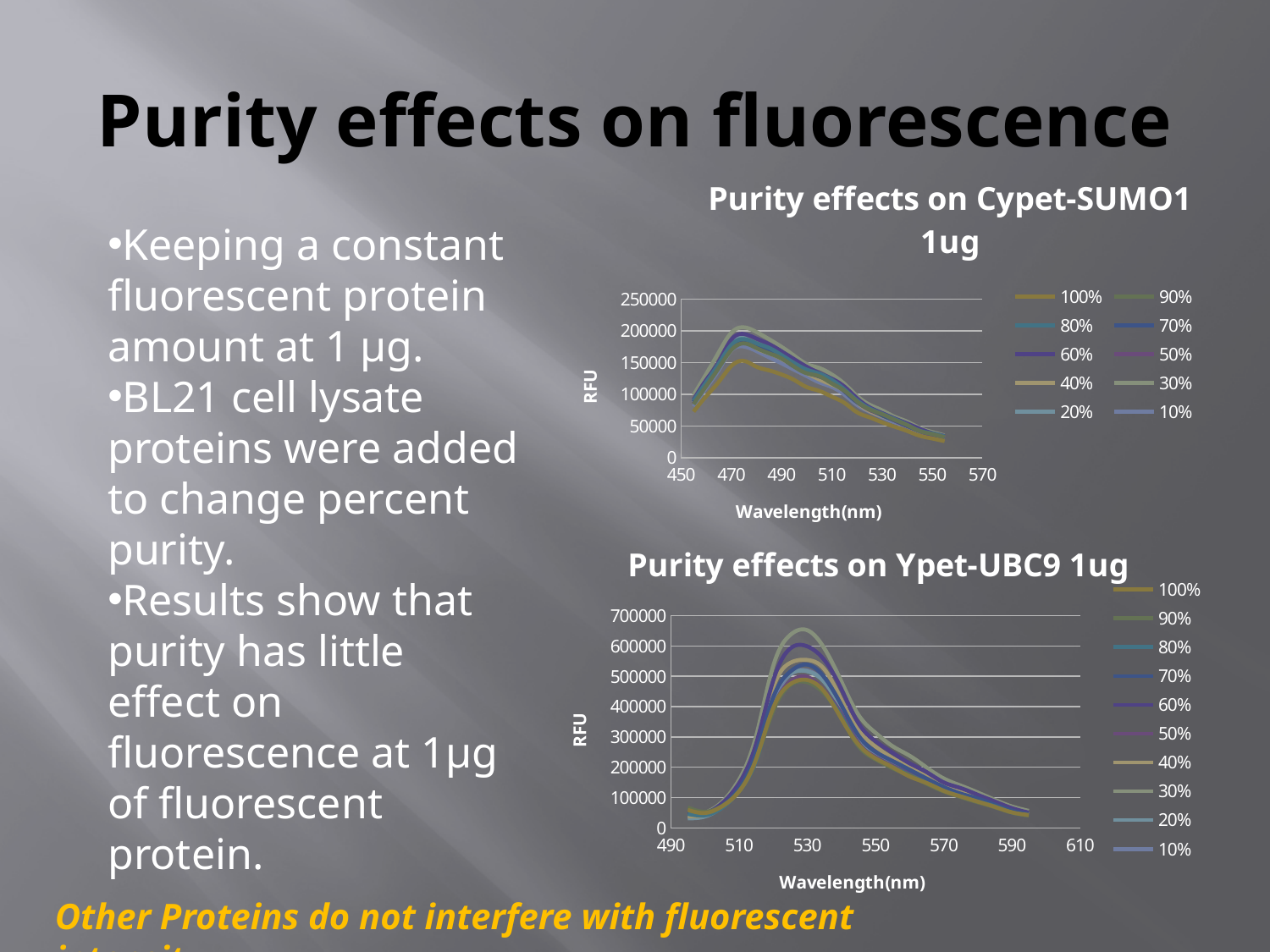
What kind of chart is "Purity effects on Ypet-UBC9 1ug"? line chart How many series does the legend of the "Purity effects on Ypet-UBC9 1ug" chart list? 10 In the "Purity effects on Cypet-SUMO1 1ug" chart, do the values rise or fall between 490 nm and 550 nm? fall In the "Purity effects on Ypet-UBC9 1ug" chart, is the peak value of the 100% series greater or less than 400000? greater In the "Purity effects on Ypet-UBC9 1ug" chart, do the values rise or fall between 530 nm and 590 nm? fall What is the y-axis label of the "Purity effects on Cypet-SUMO1 1ug" chart? RFU In the "Purity effects on Cypet-SUMO1 1ug" chart, is the highest peak value of any series greater or less than 250000? less In the "Purity effects on Ypet-UBC9 1ug" chart, is the highest peak value of any series greater or less than 700000? less How many series does the legend of the "Purity effects on Cypet-SUMO1 1ug" chart list? 10 What is the x-axis label of the "Purity effects on Ypet-UBC9 1ug" chart? Wavelength(nm) What kind of chart is "Purity effects on Cypet-SUMO1 1ug"? line chart